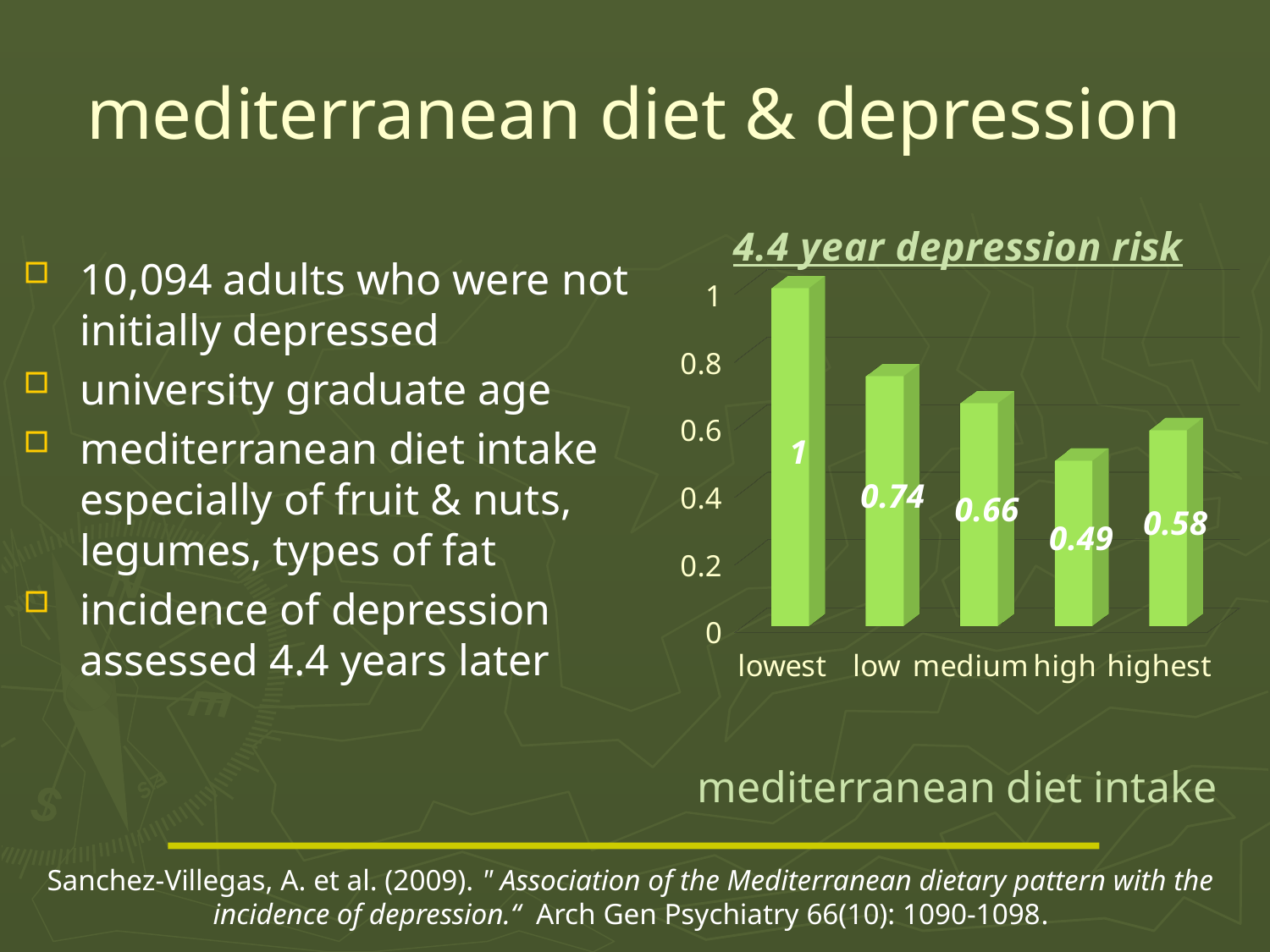
How many mediterranean diet intake categories are shown on the chart? 5 Which has a higher depression risk, the high intake group or the highest intake group? highest What kind of chart is used to show the 4.4 year depression risk? bar chart What is the 4.4 year depression risk for the lowest mediterranean diet intake group? 1 Which mediterranean diet intake group has the highest 4.4 year depression risk? lowest What is the 4.4 year depression risk for the medium intake group? 0.66 What is the title of the chart? 4.4 year depression risk Which mediterranean diet intake group has the lowest 4.4 year depression risk? high What is the difference in depression risk between the low and medium intake groups? 0.08 Is the depression risk for the low intake group greater or less than 0.6? greater What is the 4.4 year depression risk for the high mediterranean diet intake group? 0.49 What is the difference in depression risk between the lowest and highest intake groups? 0.42